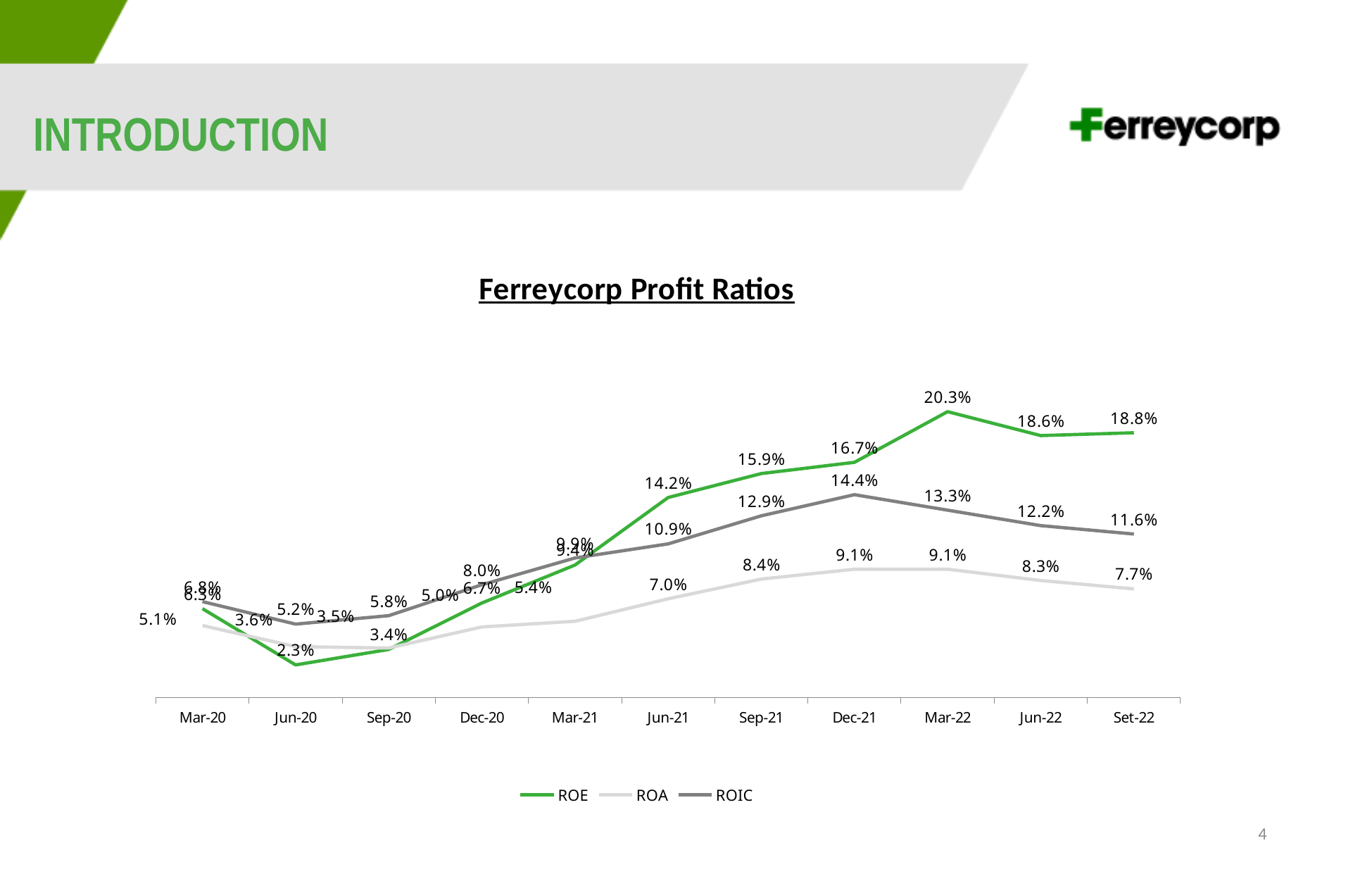
Does ROIC rise or fall from Dec-21 to Set-22? Fall What is the ROE value for Mar-22? 20.3% What is the ROA value for Set-22? 7.7% What kind of chart is shown on the slide? Line chart What is the difference between ROE and ROIC at Set-22? 7.2% How many series does the legend list? 3 At which period does ROE reach its highest value? Mar-22 What is the ROE value for Jun-20? 2.3% At which period is ROE at its lowest value? Jun-20 How many periods are shown on the x axis? 11 What is the ROIC value for Dec-21? 14.4% Which is larger at Jun-20, ROE or ROA? ROA